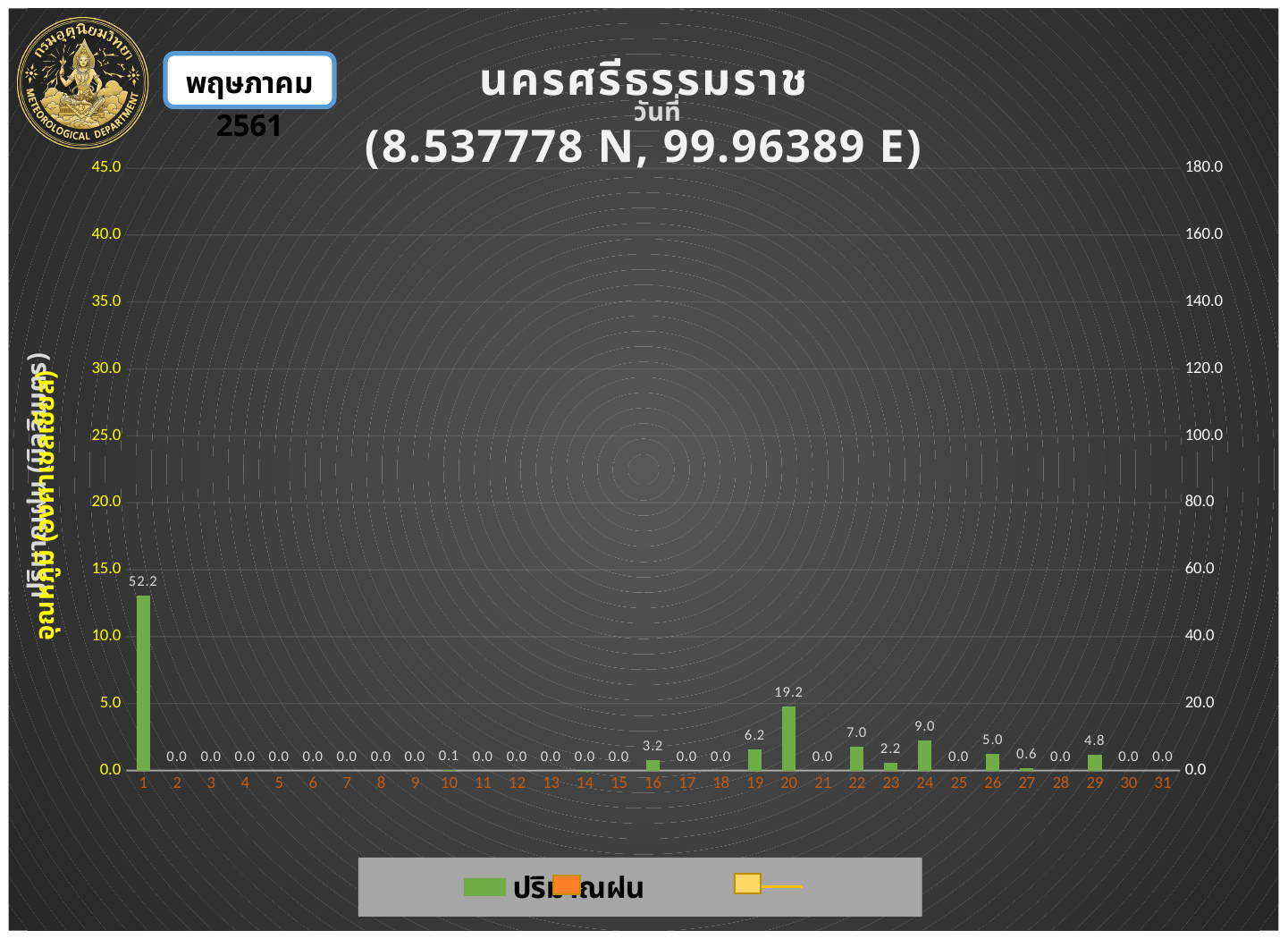
What is the value for day 22? 7.0 Which day has the highest value? 1 What is the value for day 29? 4.8 What kind of chart is this? bar chart What is the value for day 1? 52.2 How many days are shown on the x axis? 31 Which is larger, the value for day 19 or the value for day 26? day 19 What is the value for day 16? 3.2 What is the value for day 24? 9.0 What is the difference between the values for day 1 and day 20? 33.0 What is the value for day 20? 19.2 What is the difference between the values for day 24 and day 22? 2.0